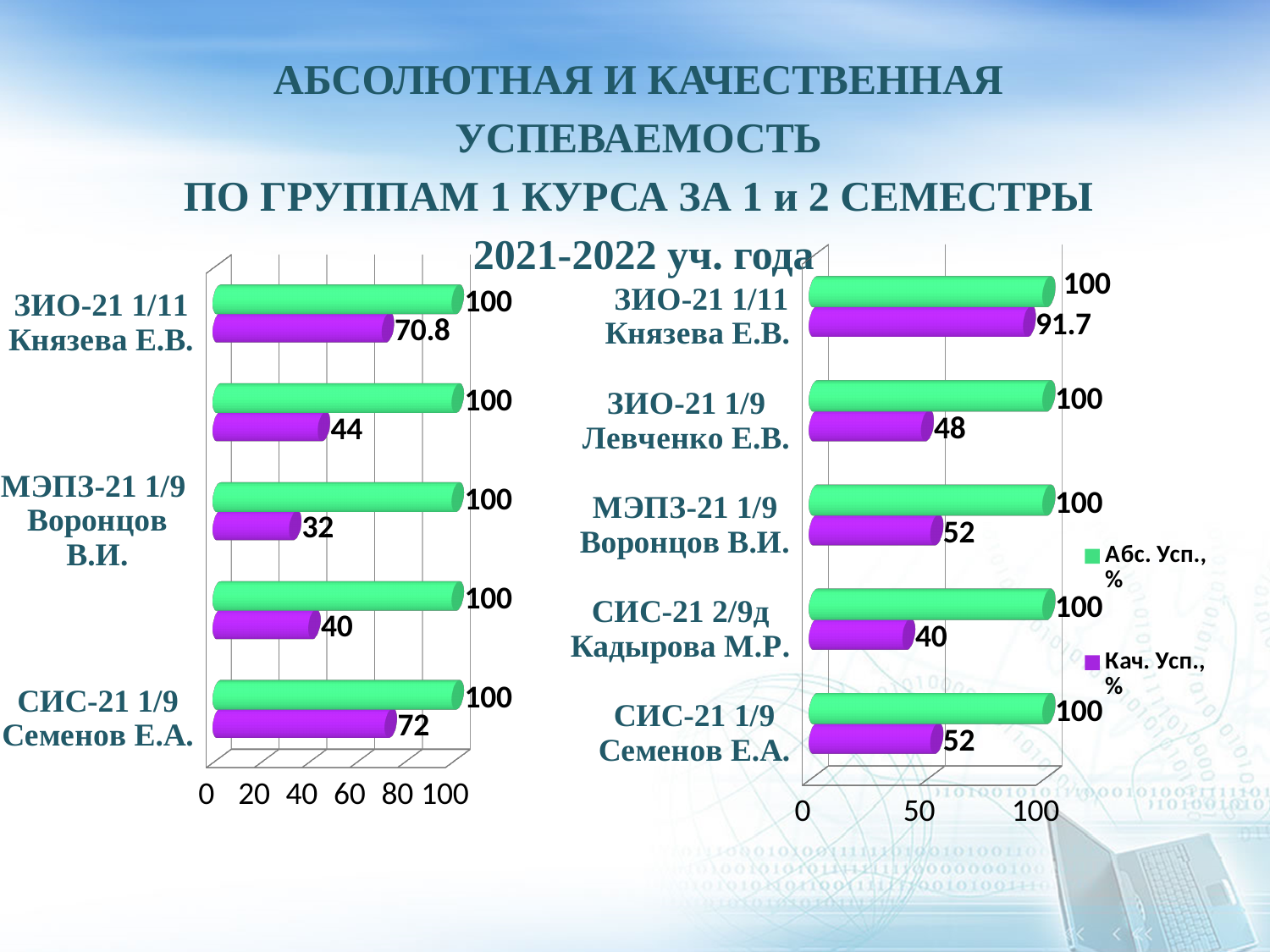
On the left chart, what is the difference between the Абс. Усп., % and Кач. Усп., % values for СИС-21 1/9 Семенов Е.А.? 28 Which is larger: the Кач. Усп., % value for МЭПЗ-21 1/9 Воронцов В.И. on the left chart or on the right chart? right chart On the left chart, what is the Кач. Усп., % value for ЗИО-21 1/11 Князева Е.В.? 70.8 How many series does the legend list? 2 On the left chart, what is the Кач. Усп., % value for МЭПЗ-21 1/9 Воронцов В.И.? 32 How many categories are shown on the right chart? 5 On the right chart, what is the Кач. Усп., % value for СИС-21 2/9д Кадырова М.Р.? 40 On the right chart, what is the difference between the Кач. Усп., % values for ЗИО-21 1/11 Князева Е.В. and МЭПЗ-21 1/9 Воронцов В.И.? 39.7 On the right chart, which category has the highest Кач. Усп., % value? ЗИО-21 1/11 Князева Е.В. On the right chart, what is the Кач. Усп., % value for ЗИО-21 1/9 Левченко Е.В.? 48 On the right chart, what is the Кач. Усп., % value for ЗИО-21 1/11 Князева Е.В.? 91.7 On the right chart, which category has the lowest Кач. Усп., % value? СИС-21 2/9д Кадырова М.Р.